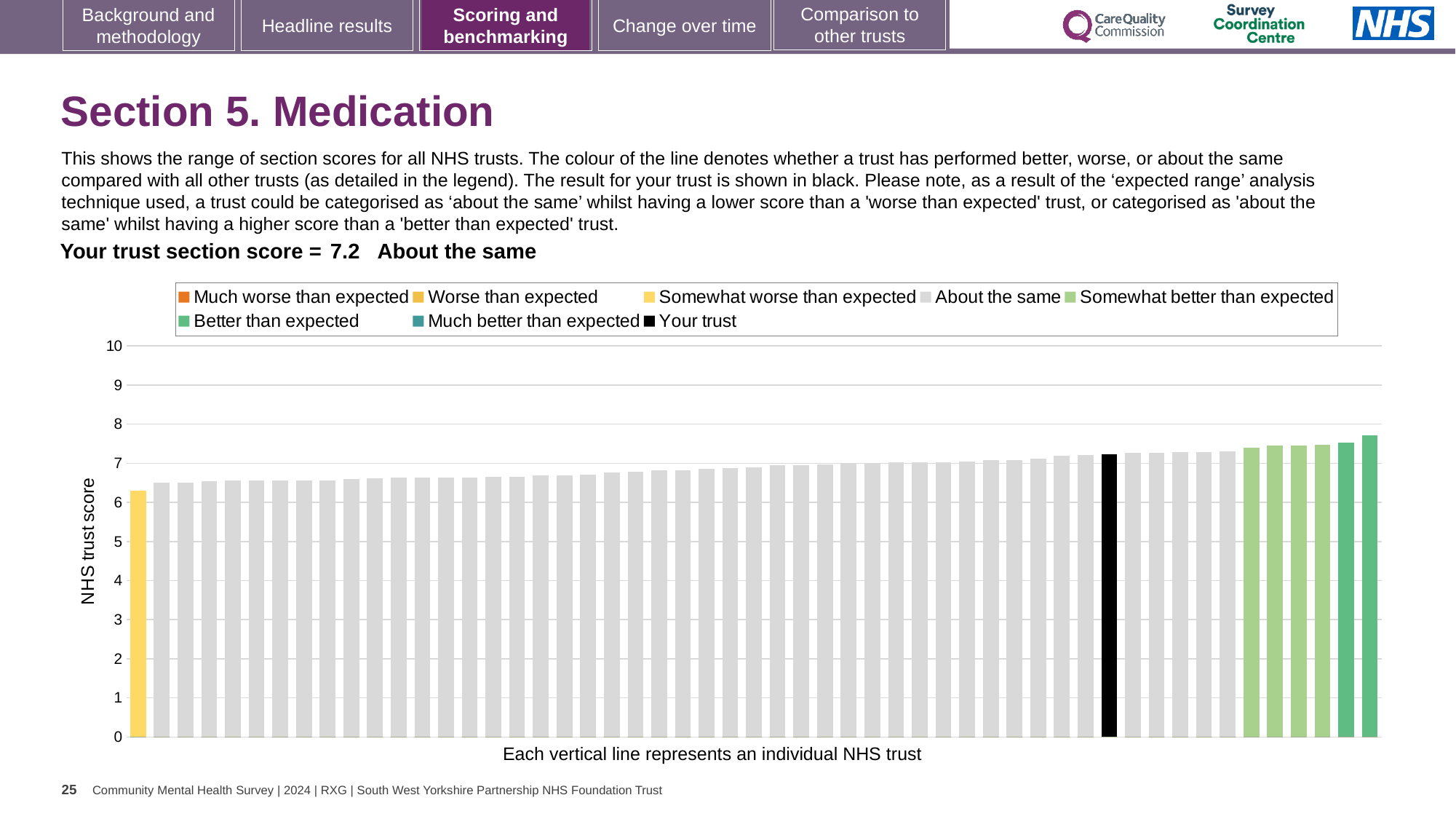
Do the bar values rise or fall from left to right along the x axis? Rise How many entries does the chart legend list? 8 Which is larger: the value for your trust (black bar) or the value for the leftmost bar? Your trust Is the value for your trust (the black bar) greater or less than 7? greater What is the label on the vertical axis of the chart? NHS trust score What colour is used for the bar representing your trust? Black What is the section score for your trust shown on the slide? 7.2 What kind of chart is shown on the slide? Bar chart Is the value for the rightmost (highest) bar greater or less than 8? less Which category is your trust placed in for this section? About the same How many bars are coloured in the darker green 'Better than expected' colour? 2 Is the value for the leftmost (lowest) bar greater or less than 7? less